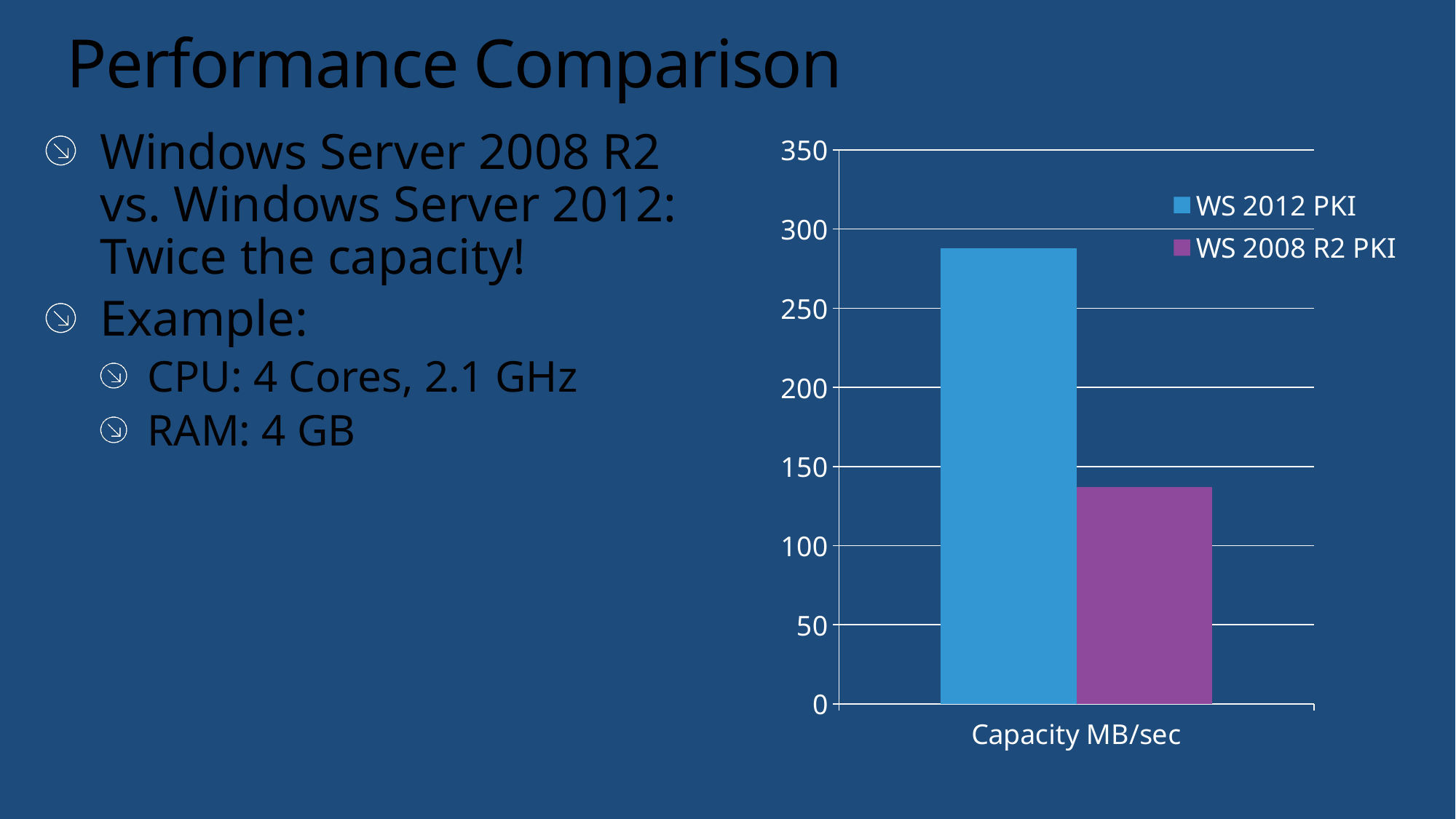
Which series has the lowest value in the chart? WS 2008 R2 PKI Is the value for WS 2012 PKI greater or less than 250? greater What is the highest value shown on the y axis of the chart? 350 Is the value for WS 2008 R2 PKI greater or less than 100? greater How many series does the chart legend list? 2 Which series has the higher value for Capacity MB/sec, WS 2012 PKI or WS 2008 R2 PKI? WS 2012 PKI What colour is the bar for WS 2008 R2 PKI? purple Is the value for WS 2008 R2 PKI greater or less than 150? less What kind of chart is shown on the slide? bar chart What is the category label on the x axis of the chart? Capacity MB/sec How many categories are shown on the x axis of the chart? 1